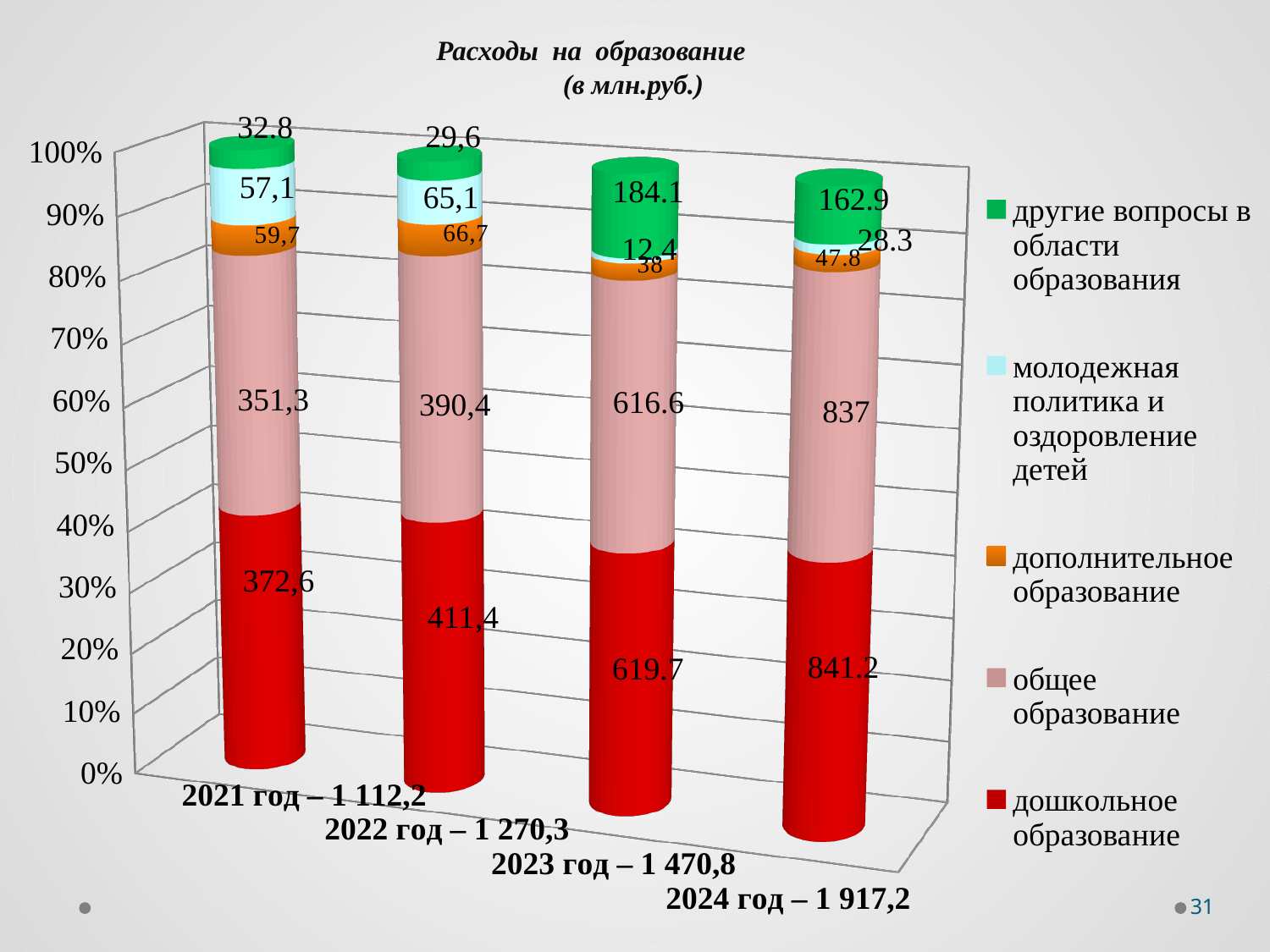
How many years are shown on the x axis? 4 What kind of chart is this? Stacked bar chart Which is larger: дополнительное образование in 2022 or in 2023? 2022 What is the value for другие вопросы в области образования in 2023? 184.1 What is the value for молодежная политика и оздоровление детей in 2022? 65,1 What is the value for общее образование in 2024? 837 What is the difference between the дошкольное образование values for 2024 and 2023? 221.5 What is the value for дошкольное образование in 2021? 372,6 In which year is the value for молодежная политика и оздоровление детей the lowest? 2023 What is the value for дополнительное образование in 2024? 47.8 In which year is the value for дошкольное образование the highest? 2024 How many series does the legend list? 5